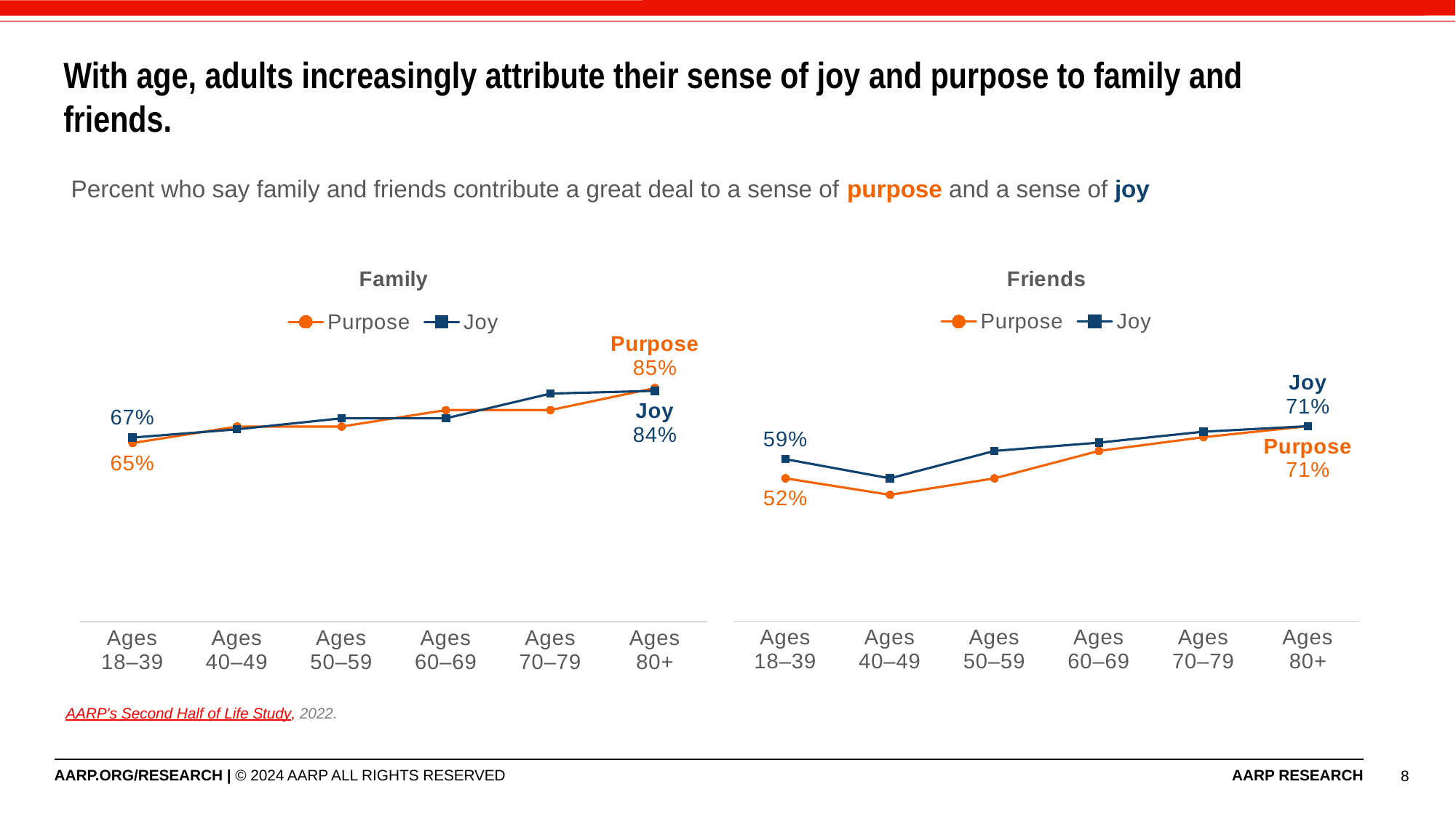
In the Family chart, does the Purpose line generally rise or fall as age increases? Rise In the Friends chart, what is the difference between the Joy and Purpose values for Ages 18–39? 7 percentage points How many series does the legend of the Family chart list? 2 In the Friends chart, what is the Joy value for Ages 80+? 71% In the Family chart, by how much does the Purpose value increase from Ages 18–39 to Ages 80+? 20 percentage points In the Friends chart, which age group has the lowest Purpose value? Ages 40–49 What kind of chart is the Family chart? Line chart How many age groups are shown on the x axis of the Friends chart? 6 In the Family chart, what is the Purpose value for Ages 80+? 85% In the Family chart, what is the Joy value for Ages 18–39? 67% In the Friends chart, what is the Purpose value for Ages 18–39? 52% In the Family chart, which is larger for Ages 18–39, the Joy value or the Purpose value? Joy